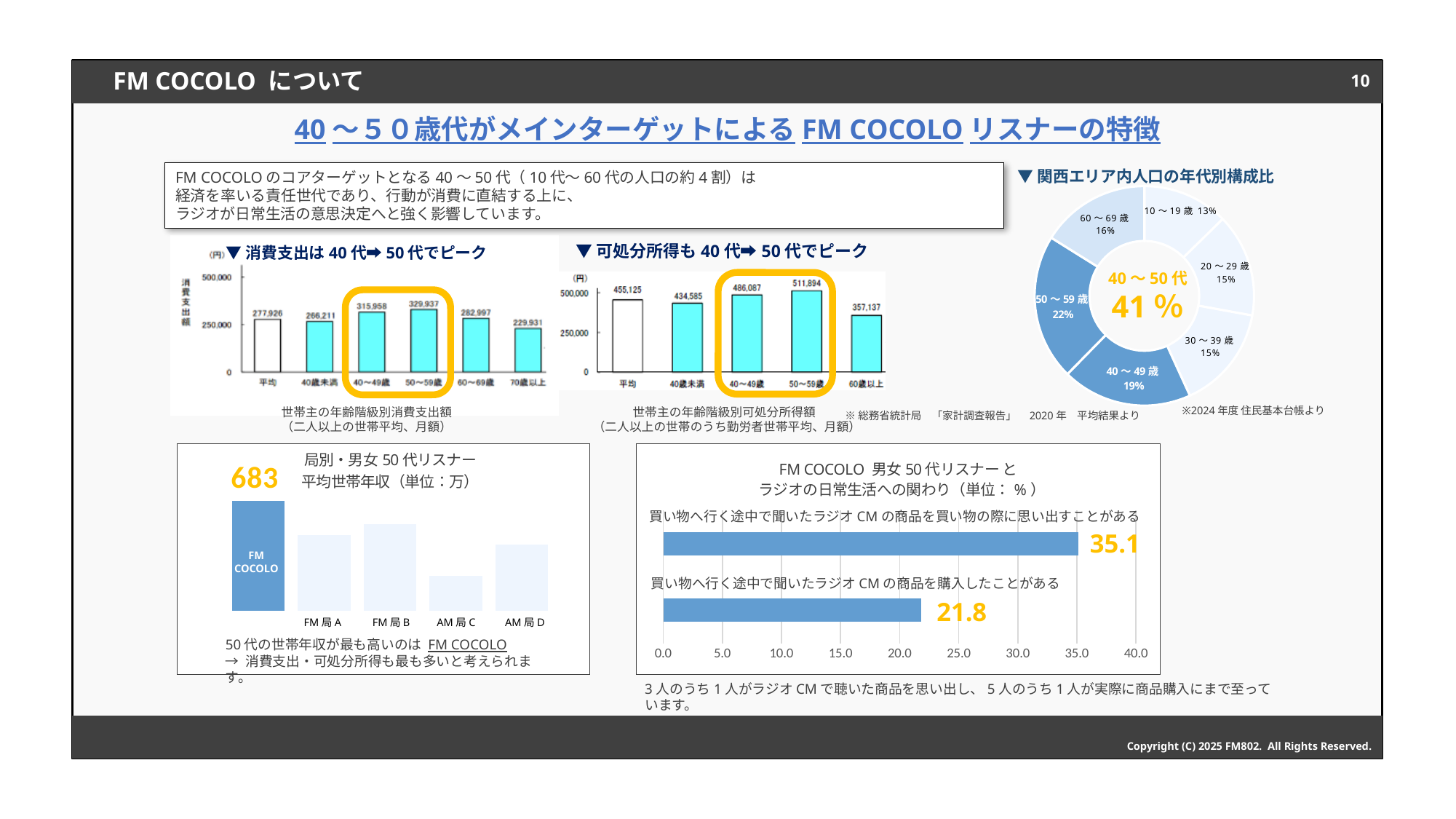
In the 局別・男女50代リスナー 平均世帯年収 bar chart, how many stations are plotted? 5 In the 消費支出 (consumption expenditure) bar chart, which age category has the lowest value? 70歳以上 In the 消費支出 (consumption expenditure) bar chart, how many bars are plotted? 6 In the 消費支出 (consumption expenditure) bar chart, what is the value for 50～59歳? 329,937 In the 可処分所得 (disposable income) bar chart, what is the difference between 50～59歳 and 60歳以上? 154,757 In the 可処分所得 (disposable income) bar chart, which category has the highest value? 50～59歳 In the 関西エリア内人口の年代別構成比 donut chart, what combined share is shown in the centre for 40～50代? 41% In the 関西エリア内人口の年代別構成比 donut chart, which age group has the smallest share? 10～19歳 In the FM COCOLO 男女50代リスナー ラジオの日常生活への関わり chart, what is the value for 買い物へ行く途中で聞いたラジオCMの商品を購入したことがある? 21.8 In the 可処分所得 (disposable income) bar chart, what is the value for 40～49歳? 486,087 In the 関西エリア内人口の年代別構成比 donut chart, what share is 50～59歳? 22% In the 局別・男女50代リスナー 平均世帯年収 bar chart, what is the value for FM COCOLO? 683